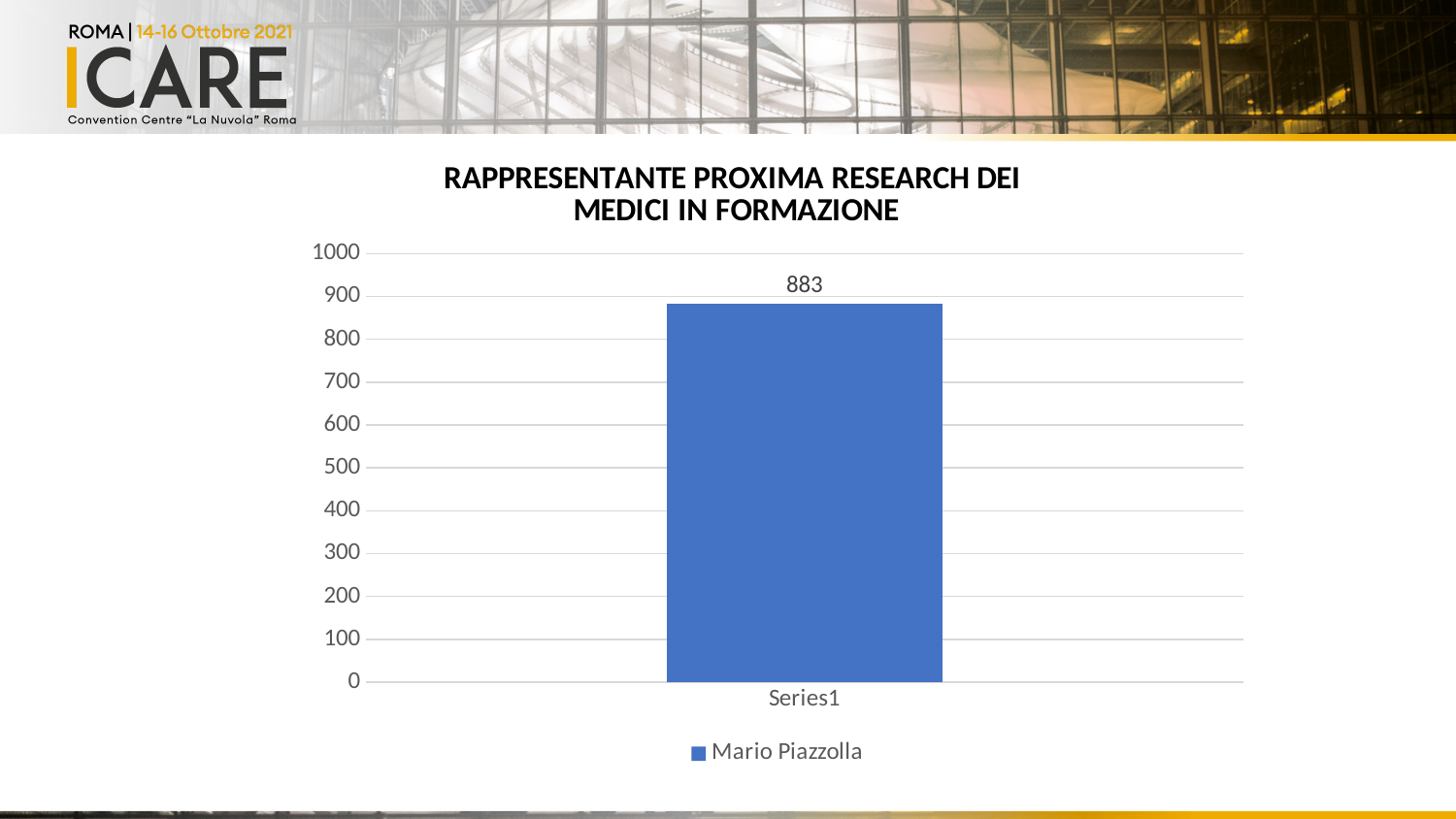
How many series does the legend list? 1 Is the value for Mario Piazzolla greater or less than 900? less Is the value for Mario Piazzolla greater or less than 800? greater How many bars are plotted in the chart? 1 What value is shown for Mario Piazzolla in the chart? 883 What name appears in the chart legend? Mario Piazzolla What is the category label shown on the x axis? Series1 What kind of chart is shown on the slide? bar chart What is the title of the chart? RAPPRESENTANTE PROXIMA RESEARCH DEI MEDICI IN FORMAZIONE What is the highest value shown on the y axis? 1000